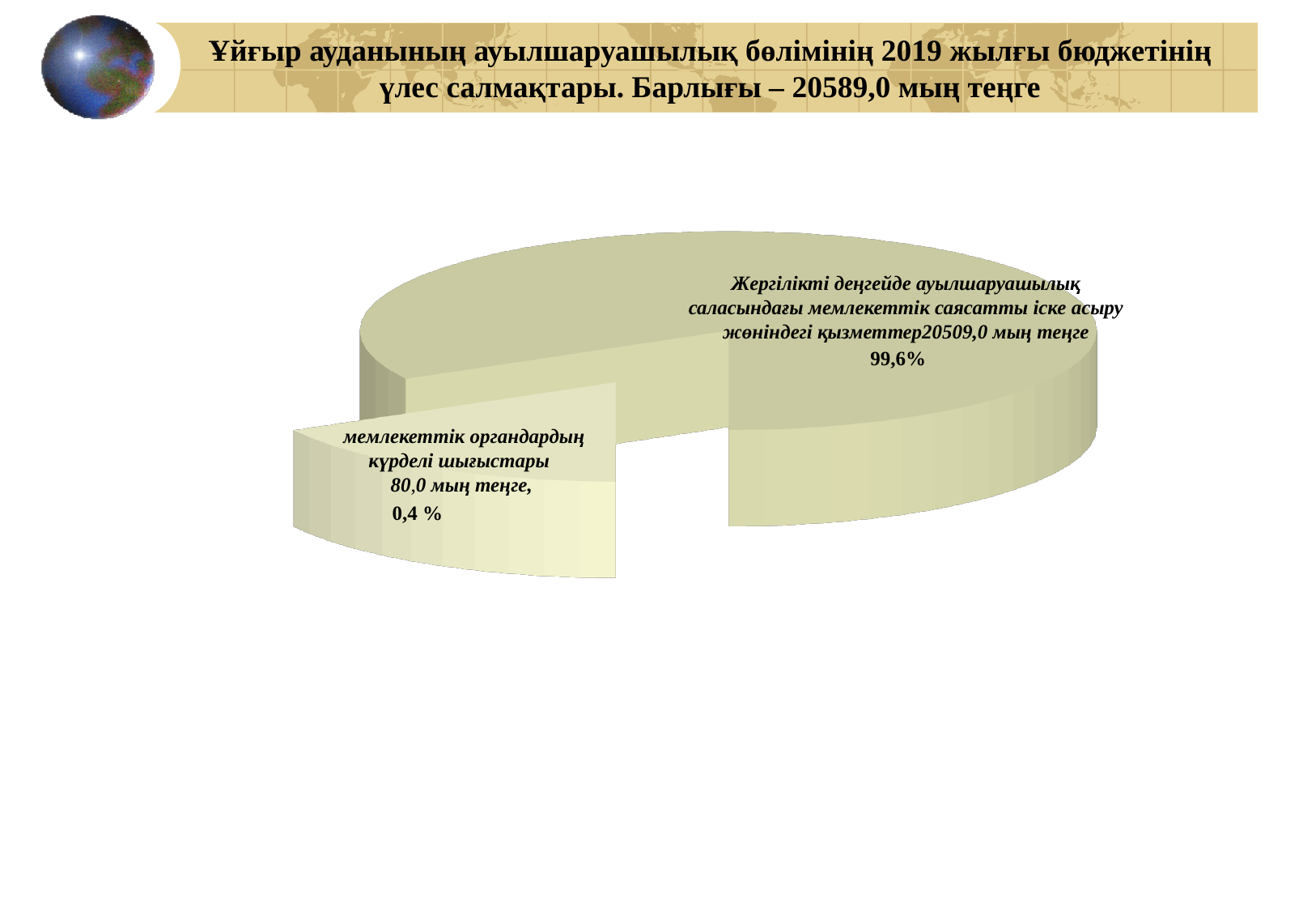
What is the value shown for "мемлекеттік органдардың күрделі шығыстары"? 80,0 мың теңге What is the value shown for "Жергілікті деңгейде ауылшаруашылық саласындағы мемлекеттік саясатты іске асыру жөніндегі қызметтер"? 20509,0 мың теңге Which is larger: the value for "мемлекеттік органдардың күрделі шығыстары" or the value for "Жергілікті деңгейде ауылшаруашылық саласындағы мемлекеттік саясатты іске асыру жөніндегі қызметтер"? Жергілікті деңгейде ауылшаруашылық саласындағы мемлекеттік саясатты іске асыру жөніндегі қызметтер Which slice of the pie chart is the largest? Жергілікті деңгейде ауылшаруашылық саласындағы мемлекеттік саясатты іске асыру жөніндегі қызметтер What share of the pie does the slice "Жергілікті деңгейде ауылшаруашылық саласындағы мемлекеттік саясатты іске асыру жөніндегі қызметтер" represent? 99,6% How many slices does the pie chart have? 2 What share of the pie does the slice "мемлекеттік органдардың күрделі шығыстары" represent? 0,4 % Which slice of the pie chart is the smallest? мемлекеттік органдардың күрделі шығыстары What total budget amount is stated in the slide title? 20589,0 мың теңге Which year's budget does the slide title refer to? 2019 What kind of chart is shown on the slide? pie chart What is the difference between the two slice values, 20509,0 and 80,0 мың теңге? 20429,0 мың теңге